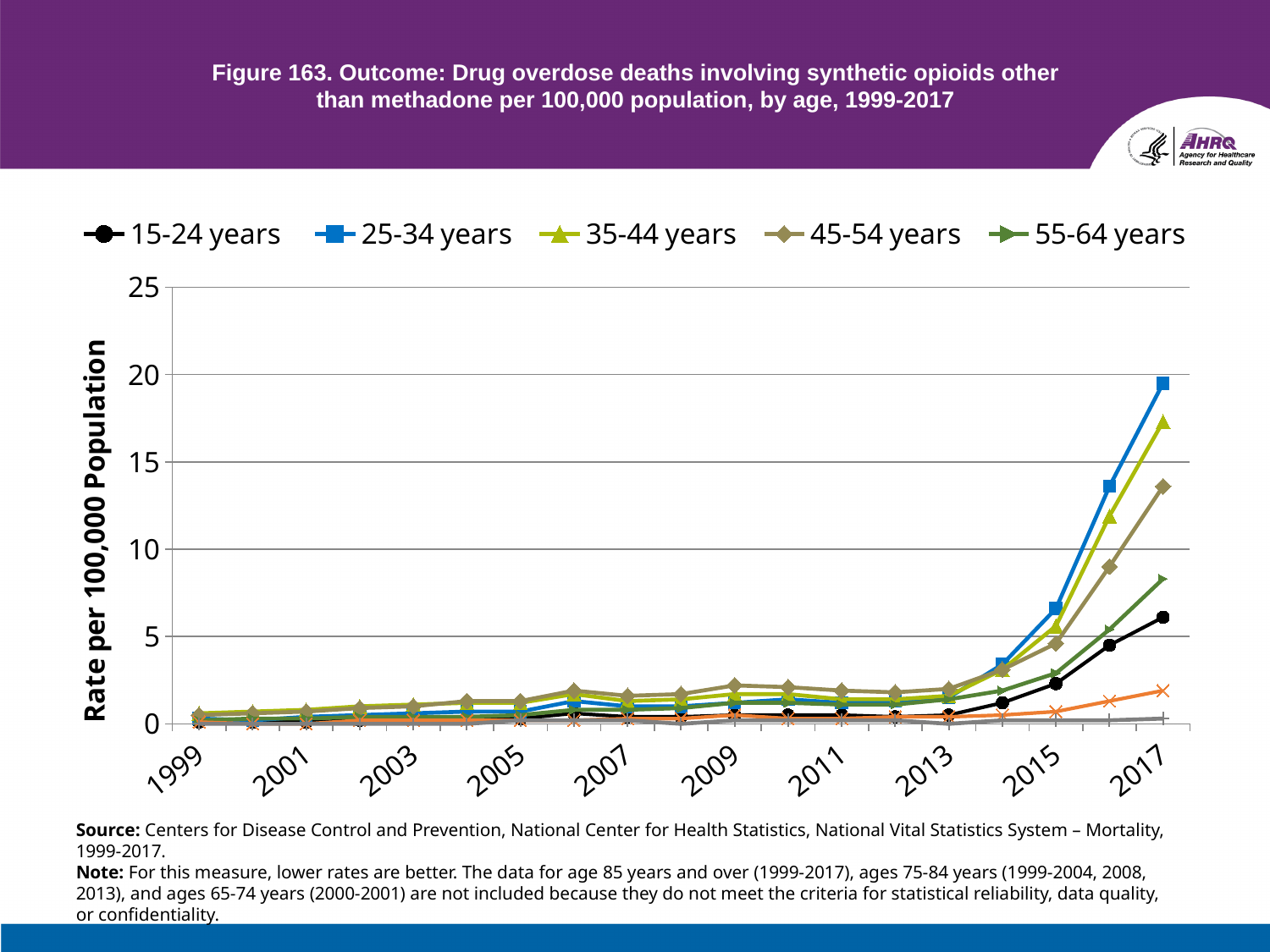
How many series does the legend list? 5 What kind of chart is shown on the slide? line chart Do the rates for 25-34 years rise or fall between 2013 and 2017? rise How many years are plotted along the x axis? 19 Is the value for 15-24 years in 2017 greater or less than 5? greater Among the age groups listed in the legend, which has the lowest rate in 2017? 15-24 years Is the value for 55-64 years in 2017 greater or less than 10? less Which is larger in 2017, the rate for 35-44 years or the rate for 55-64 years? 35-44 years Which age group has the highest rate in 2017? 25-34 years What is the label of the y axis? Rate per 100,000 Population Is the value for 45-54 years in 2017 greater or less than 15? less